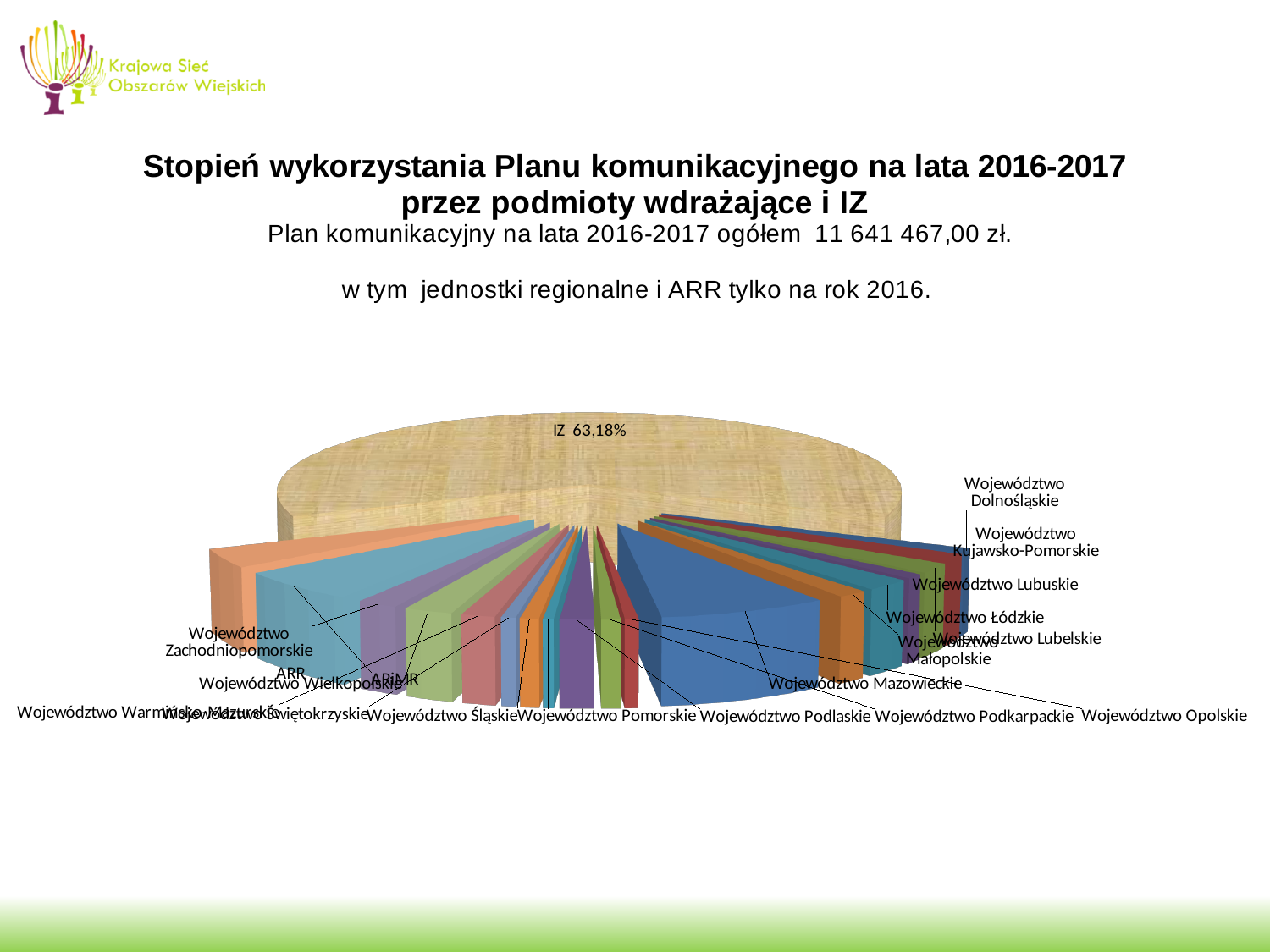
Which is larger, the slice for IZ or the slice for Województwo Lubuskie? IZ What is the total value of the Plan komunikacyjny na lata 2016-2017 stated on the slide? 11 641 467,00 zł Which is larger, the slice for IZ or the slice for Województwo Zachodniopomorskie? IZ What share of the pie does IZ account for? 63,18% Is the share for IZ greater or less than 50%? greater What kind of chart is shown on the slide? pie chart Which years does the slide title say the communication plan covers? 2016-2017 Which slice of the pie is the largest? IZ